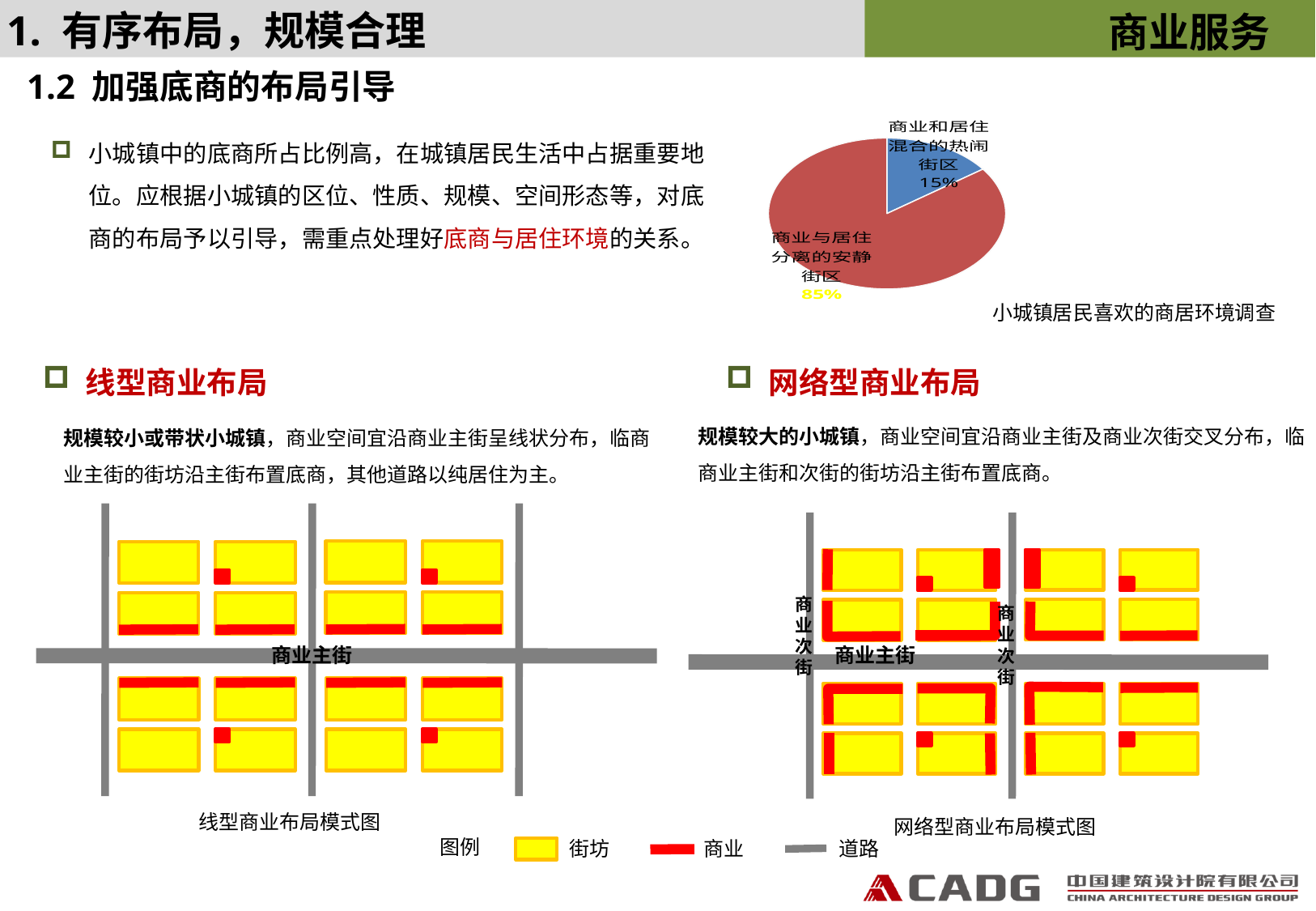
Which slice of the pie chart is the smallest? 商业和居住混合的热闹街区 Which is larger in the pie chart: 商业和居住混合的热闹街区 or 商业与居住分离的安静街区? 商业与居住分离的安静街区 What colour is the 商业与居住分离的安静街区 slice in the pie chart? red Which slice of the pie chart is the largest? 商业与居住分离的安静街区 What is the difference in percentage points between the two slices of the pie chart? 70 In the pie chart, what share is labelled for 商业和居住混合的热闹街区? 15% How many slices does the pie chart have? 2 What kind of chart is shown in the top right of the slide? pie chart What is the caption of the pie chart? 小城镇居民喜欢的商居环境调查 In the pie chart, what share is labelled for 商业与居住分离的安静街区? 85% Is the share for 商业和居住混合的热闹街区 in the pie chart greater or less than 50%? less